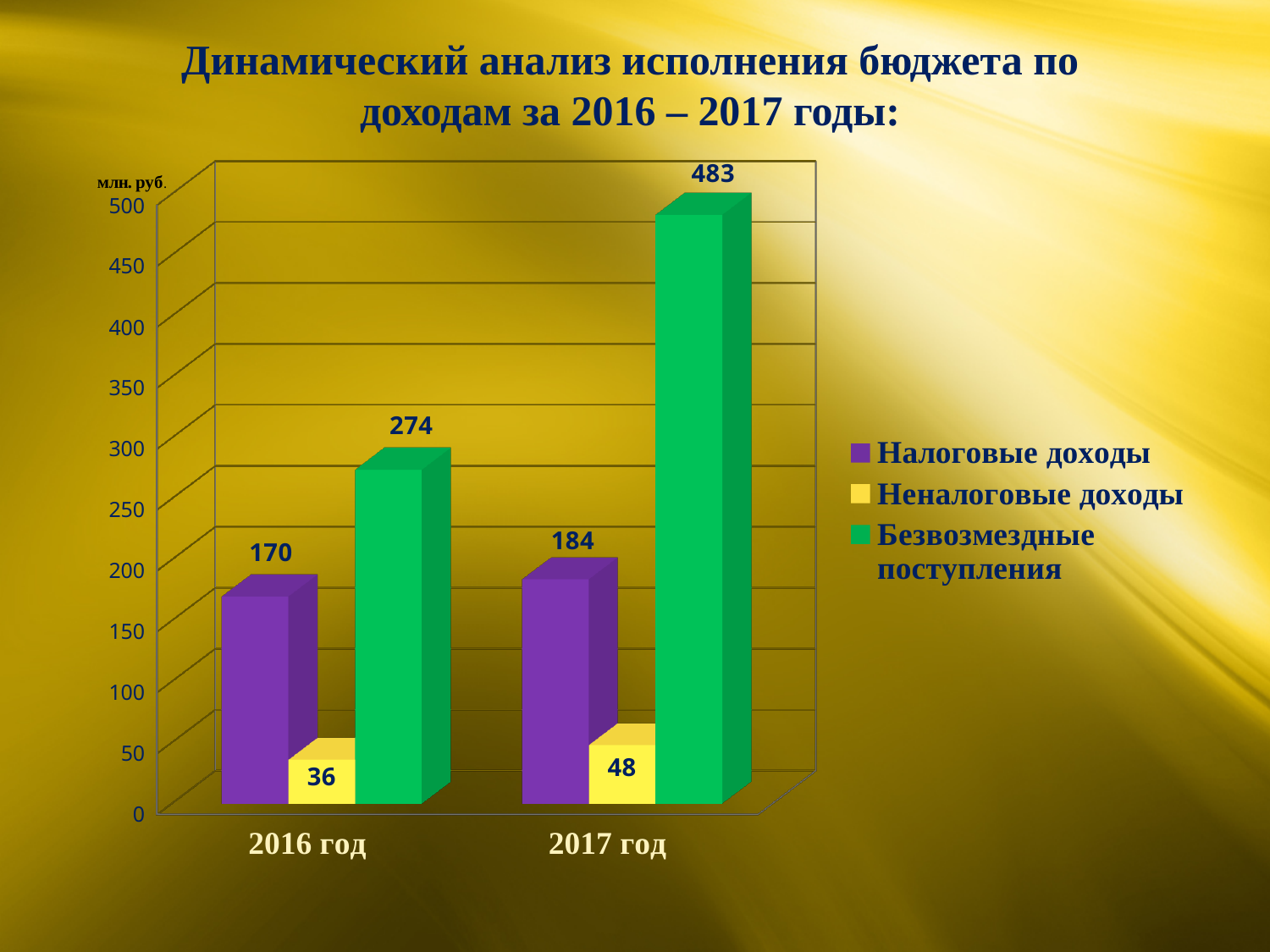
By how much did Безвозмездные поступления increase from 2016 год to 2017 год? 209 What unit is indicated on the vertical axis? млн. руб. Which series has the highest value in 2017 год? Безвозмездные поступления How many year categories are shown on the x axis? 2 How many series does the legend list? 3 What is the value of Налоговые доходы for 2016 год? 170 What is the value of Неналоговые доходы for 2016 год? 36 What kind of chart is shown on the slide? Bar chart What is the value of Безвозмездные поступления for 2017 год? 483 What is the difference between Налоговые доходы and Неналоговые доходы in 2017 год? 136 Which is larger: Налоговые доходы in 2016 год or Налоговые доходы in 2017 год? 2017 год Which series has the lowest value in 2016 год? Неналоговые доходы